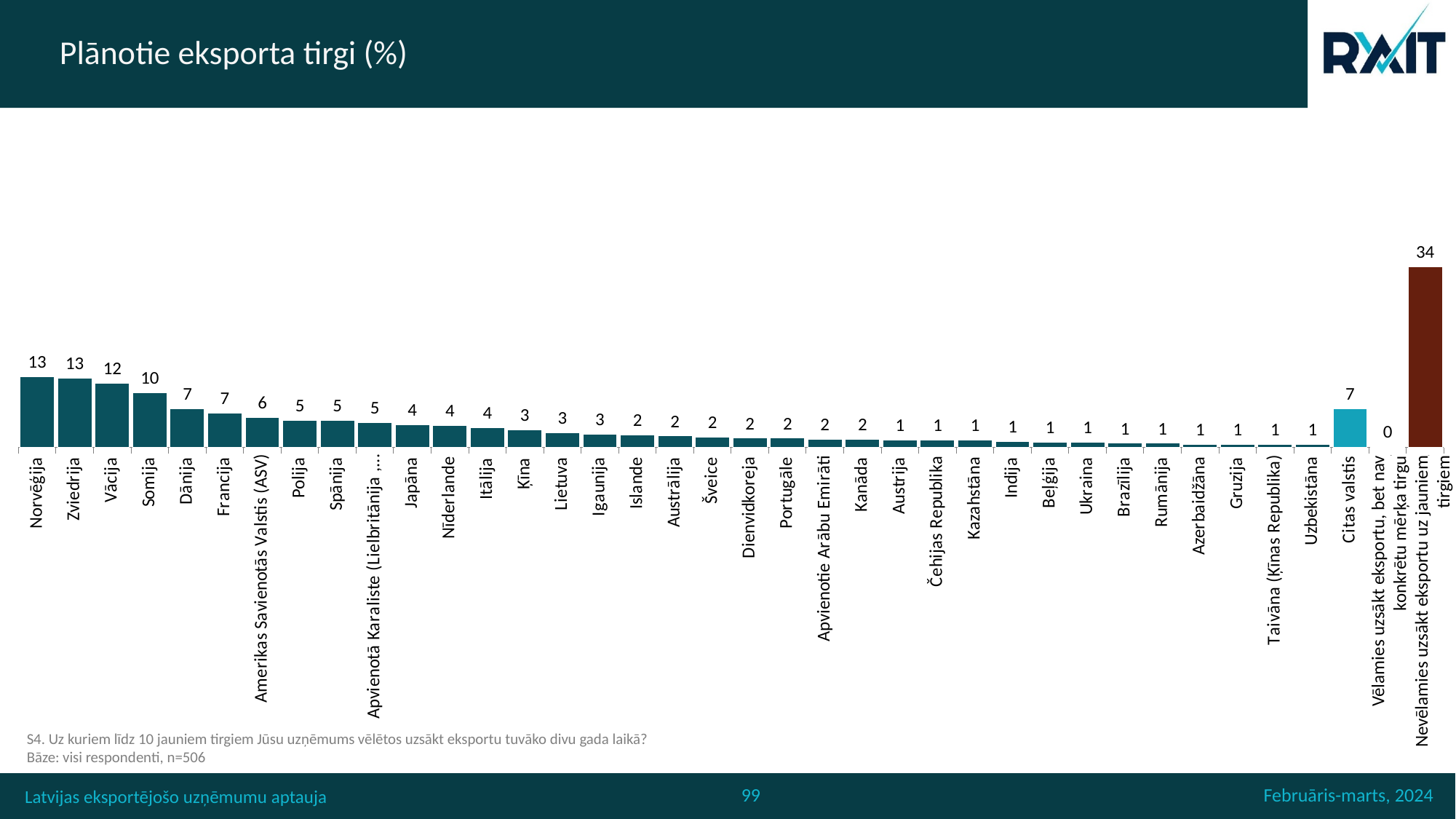
What is the difference between the value for Nevēlamies uzsākt eksportu uz jauniem tirgiem and the value for Norvēģija? 21 What is the value for Vācija? 12 What is the title of the chart? Plānotie eksporta tirgi (%) How many countries have a value of 13? 2 Which category has the highest value? Nevēlamies uzsākt eksportu uz jauniem tirgiem What kind of chart is shown on the slide? Bar chart Which is larger, the value for Dānija or the value for Amerikas Savienotās Valstis (ASV)? Dānija What is the value for Somija? 10 What is the difference between the values for Vācija and Somija? 2 What is the value for Amerikas Savienotās Valstis (ASV)? 6 Which category has the lowest value? Vēlamies uzsākt eksportu, bet nav konkrētu mērķa tirgu What is the value for Citas valstis? 7